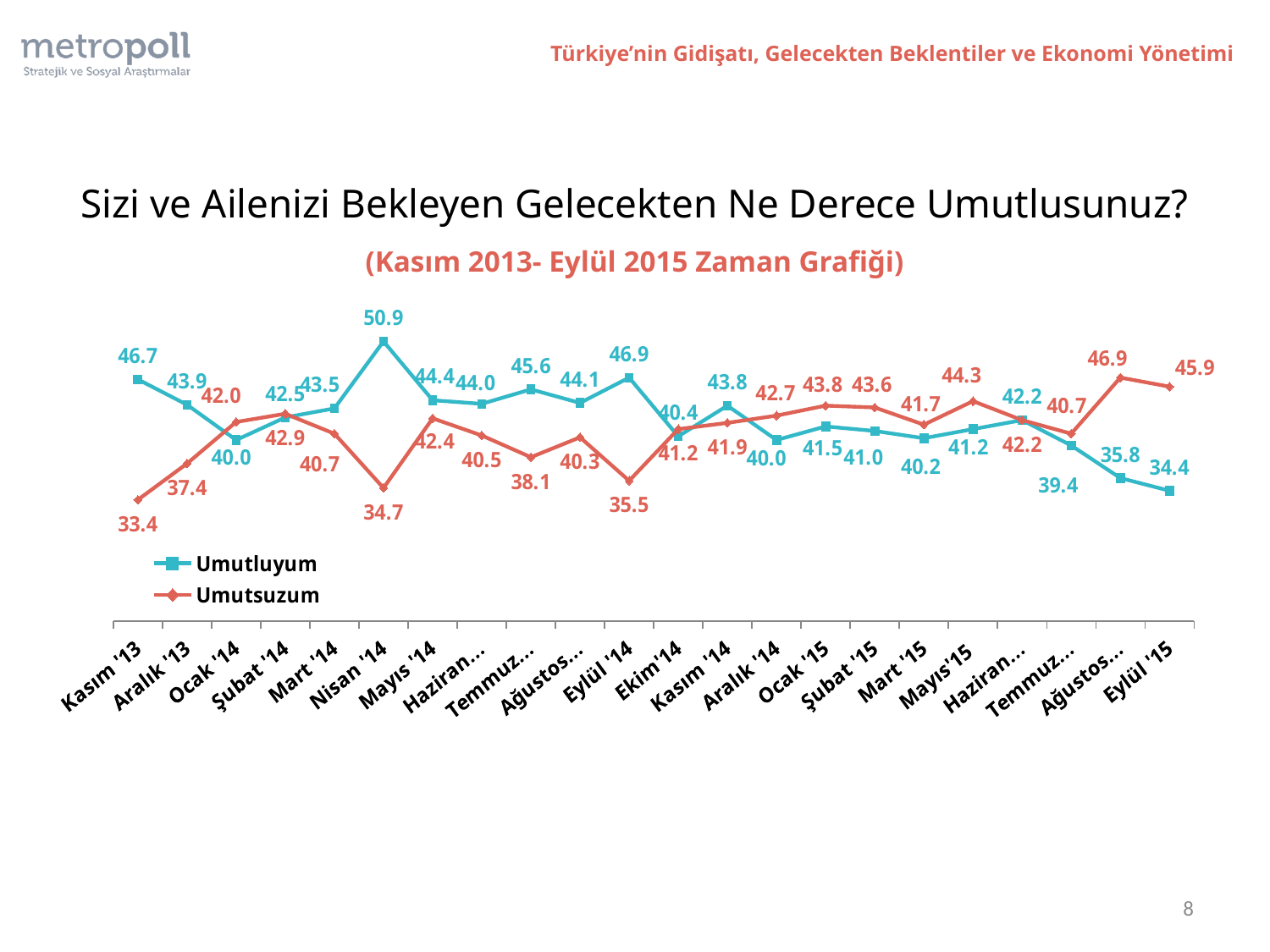
In which period does the Umutluyum series reach its highest value? Nisan '14 What type of chart is shown on the slide? Line chart What is the difference between the Umutsuzum and Umutluyum values for Eylül '15? 11.5 Which series has the larger value for Eylül '14, Umutluyum or Umutsuzum? Umutluyum What is the Umutsuzum value for Ağustos '15? 46.9 What is the Umutluyum value for Eylül '15? 34.4 In which period does the Umutsuzum series have its lowest value? Kasım '13 What is the Umutluyum value for Nisan '14? 50.9 How many time periods are shown on the x axis? 22 How many series does the legend list? 2 What is the subtitle shown below the chart title? (Kasım 2013- Eylül 2015 Zaman Grafiği) What is the Umutsuzum value for Kasım '13? 33.4